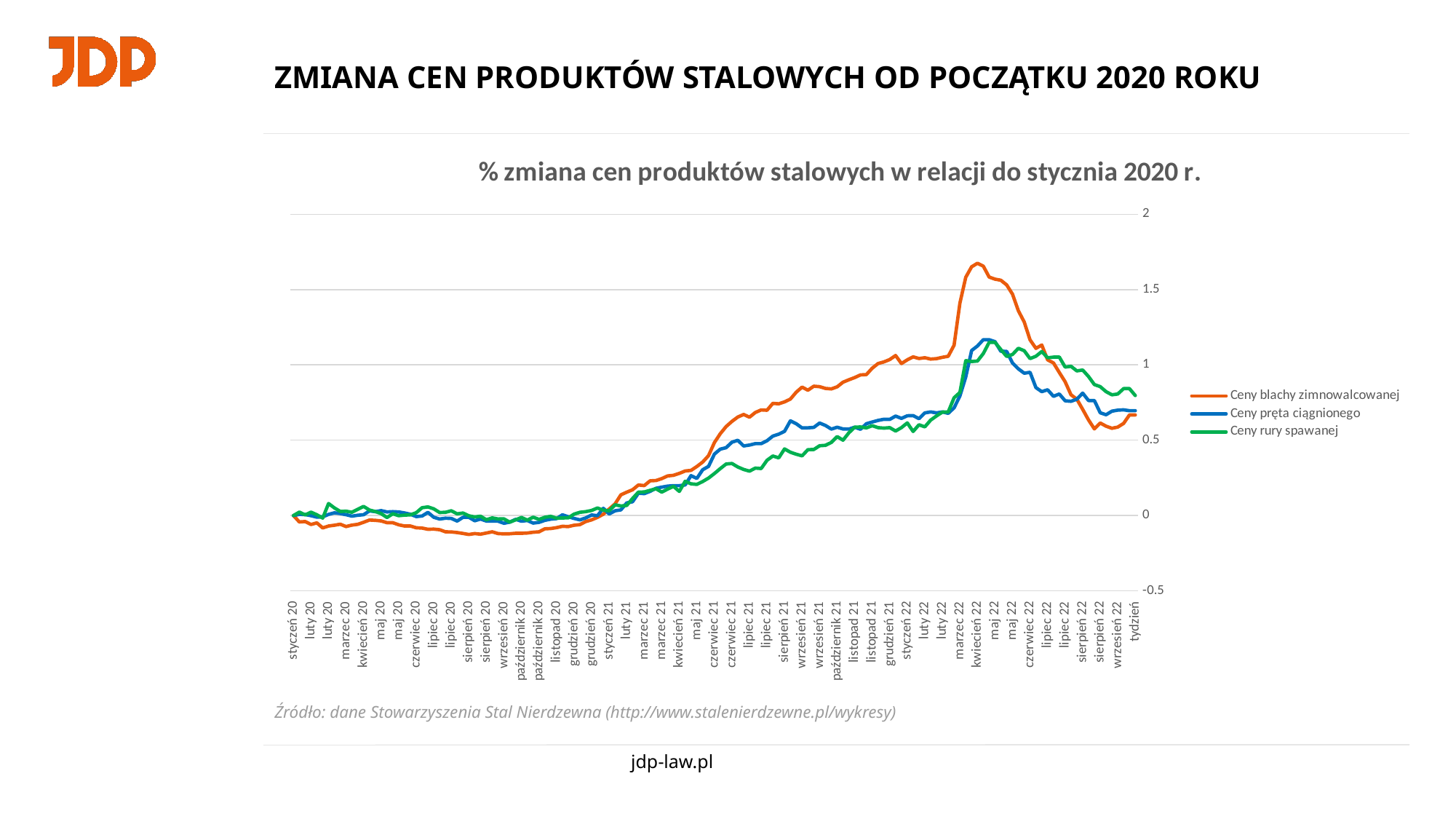
Is the value for Ceny rury spawanej at wrzesień 22 greater or less than 1? less Do the values for Ceny blachy zimnowalcowanej rise or fall between styczeń 21 and kwiecień 22? rise What are the three series named in the legend? Ceny blachy zimnowalcowanej, Ceny pręta ciągnionego, Ceny rury spawanej What is the title of the chart? % zmiana cen produktów stalowych w relacji do stycznia 2020 r. How many series does the legend list? 3 Around kwiecień 22, which series is higher, Ceny blachy zimnowalcowanej or Ceny rury spawanej? Ceny blachy zimnowalcowanej What kind of chart is shown on the slide? line chart Is the peak value of Ceny pręta ciągnionego greater or less than 1.5? less Which series reaches the highest value on the chart? Ceny blachy zimnowalcowanej Is the value for Ceny pręta ciągnionego at styczeń 21 greater or less than 0.5? less Do the values for Ceny blachy zimnowalcowanej rise or fall between kwiecień 22 and sierpień 22? fall